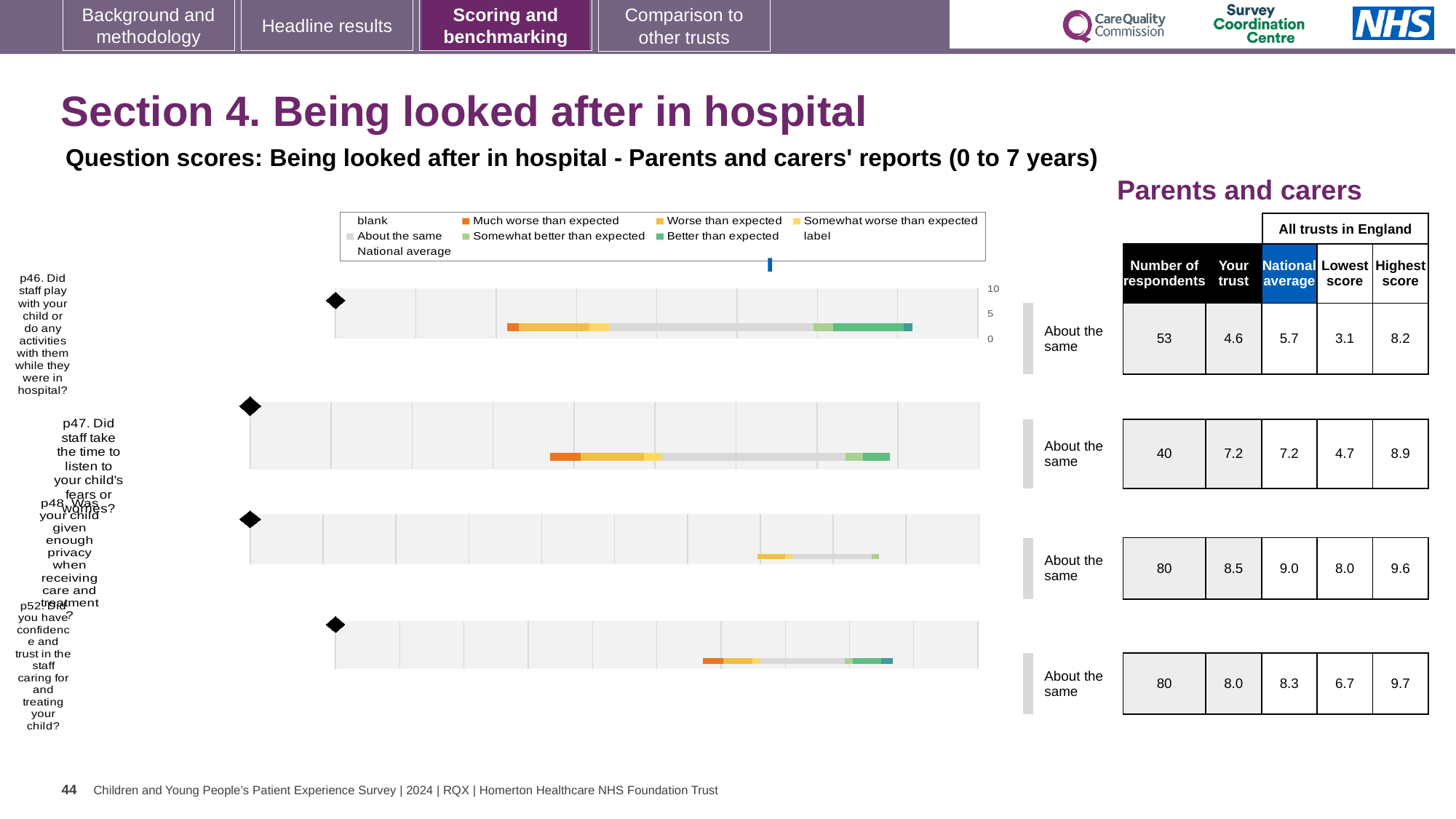
Which question has the highest 'Your trust' score in the table? p48 How many respondents are listed for p47 (Did staff take the time to listen to your child's fears or worries?)? 40 Which question has the lowest 'Your trust' score in the table? p46 What is the Lowest score among all trusts in England for p47? 4.7 What is the Highest score among all trusts in England for p52 (Did you have confidence and trust in the staff caring for and treating your child?)? 9.7 For p52, which is larger: the 'Your trust' score or the National average score? National average In the table, what is the National average score for p48 (Was your child given enough privacy when receiving care and treatment?)? 9.0 In the table next to the charts, what is the 'Your trust' score for p46 (Did staff play with your child or do any activities with them while they were in hospital?)? 4.6 For p46, how much higher is the National average score than the 'Your trust' score? 1.1 What kind of chart is used to show the question scores on this slide? bar chart What benchmark category is shown for p46 next to its chart? About the same How many survey questions (p46, p47, p48, p52) are plotted on the slide? 4